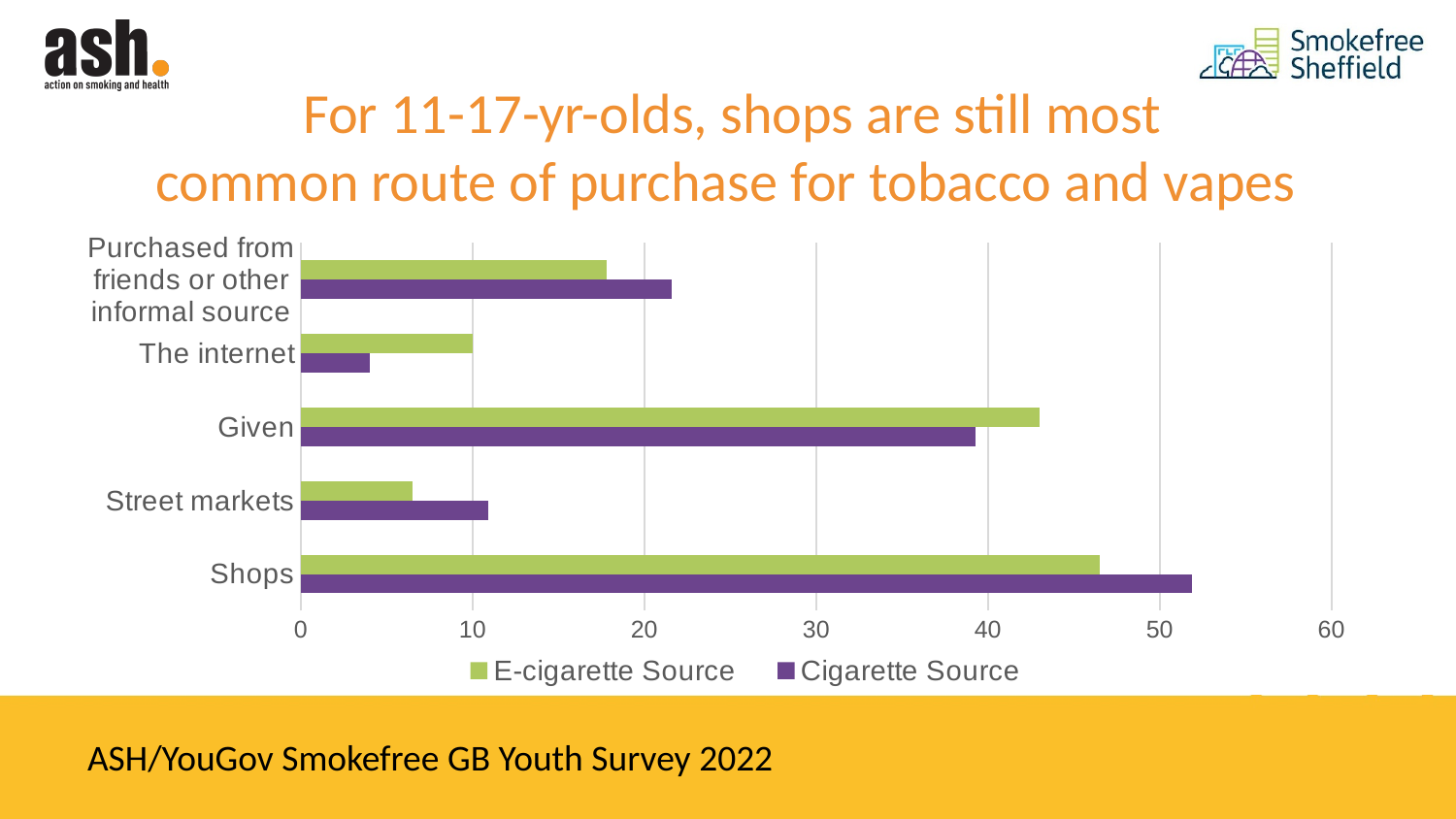
Which category has the lowest value for Cigarette Source? The internet Is the Cigarette Source value for Shops greater or less than 50? greater Is the Cigarette Source value for The internet greater or less than 10? less Is the E-cigarette Source value for Given greater or less than 40? greater What kind of chart is shown on the slide? bar chart For The internet, which is larger: the E-cigarette Source value or the Cigarette Source value? E-cigarette Source How many series does the legend list? 2 For Shops, which is larger: the E-cigarette Source value or the Cigarette Source value? Cigarette Source Which category has the highest value for Cigarette Source? Shops How many categories are shown on the chart? 5 Which category has the highest value for E-cigarette Source? Shops Which category has the lowest value for E-cigarette Source? Street markets